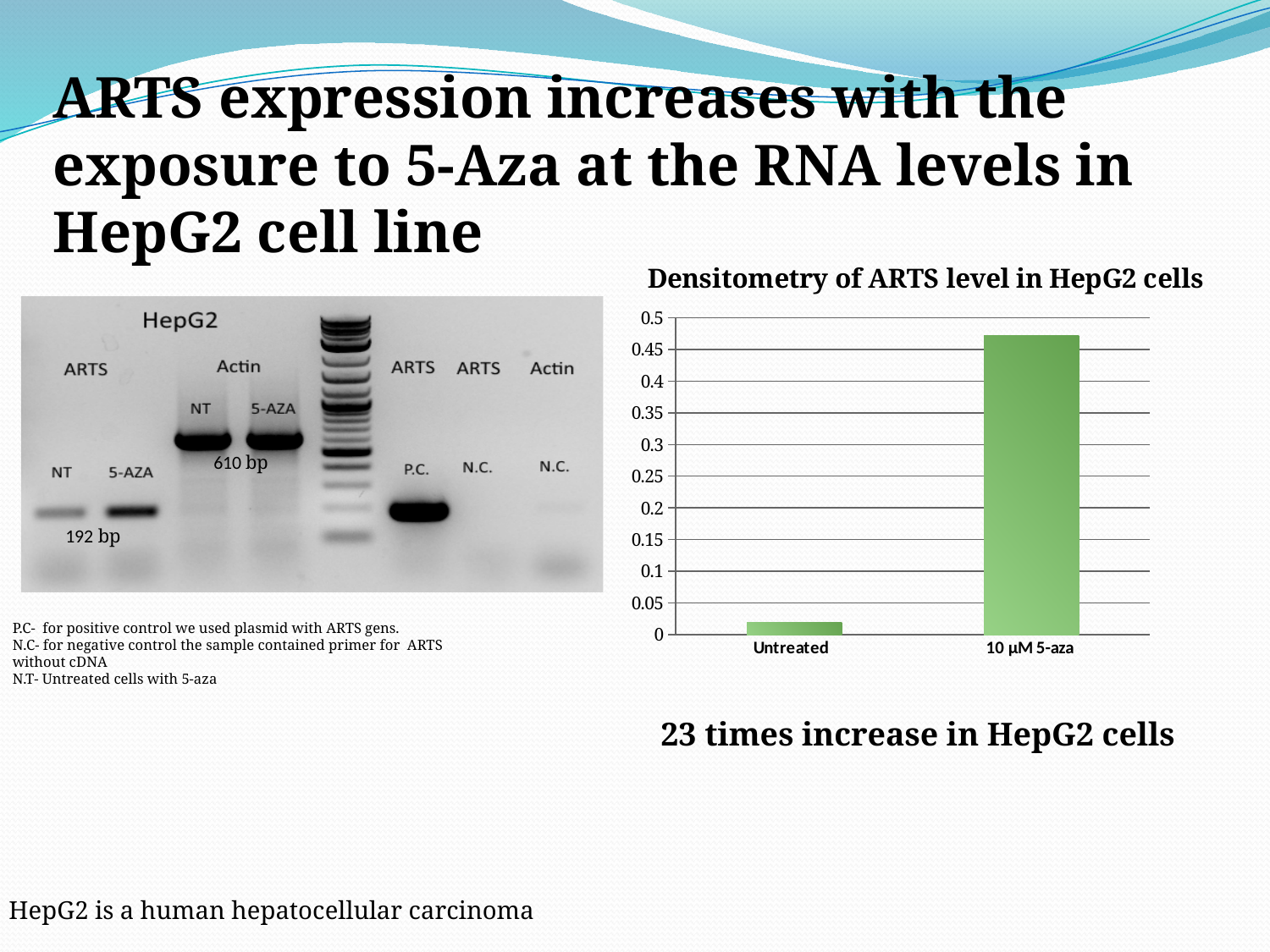
What kind of chart is shown on the slide? bar chart Which category has the highest value in the chart? 10 µM 5-aza Is the value for 10 µM 5-aza greater or less than 0.4? greater What is the maximum value shown on the chart's vertical axis? 0.5 Do the values rise or fall from Untreated to 10 µM 5-aza along the x axis? rise Is the value for Untreated greater or less than 0.05? less Is the value for 10 µM 5-aza greater or less than 0.5? less Which category has the lowest value in the chart? Untreated What is the title of the chart on the slide? Densitometry of ARTS level in HepG2 cells Which is larger, the value for Untreated or the value for 10 µM 5-aza? 10 µM 5-aza How many categories are plotted in the chart? 2